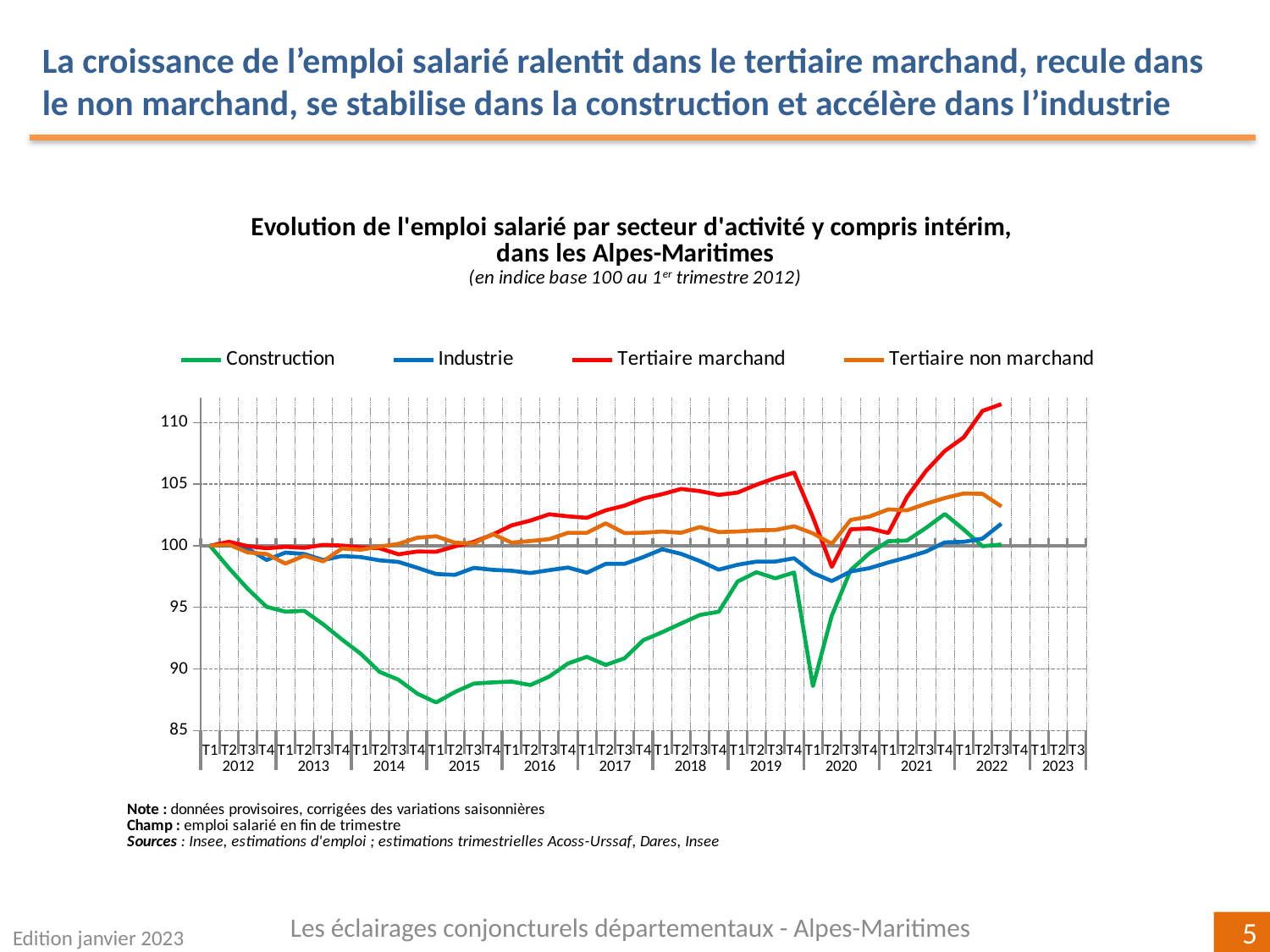
Is the value for Construction at T1 2020 greater or less than 90? less Is the value for Tertiaire marchand at T3 2022 greater or less than 110? greater Does the Construction series rise or fall between T1 2012 and T1 2015? fall How many series does the legend list? 4 What kind of chart is shown on the slide? line chart Which series is the highest at the last plotted point (T3 2022)? Tertiaire marchand Which series is the lowest at T1 2020? Construction What colour is the Construction line? green At T1 2015, which is larger: Construction or Industrie? Industrie Is the value for Industrie at T4 2014 greater or less than 100? less Does the Tertiaire marchand series rise or fall between T2 2020 and T3 2022? rise